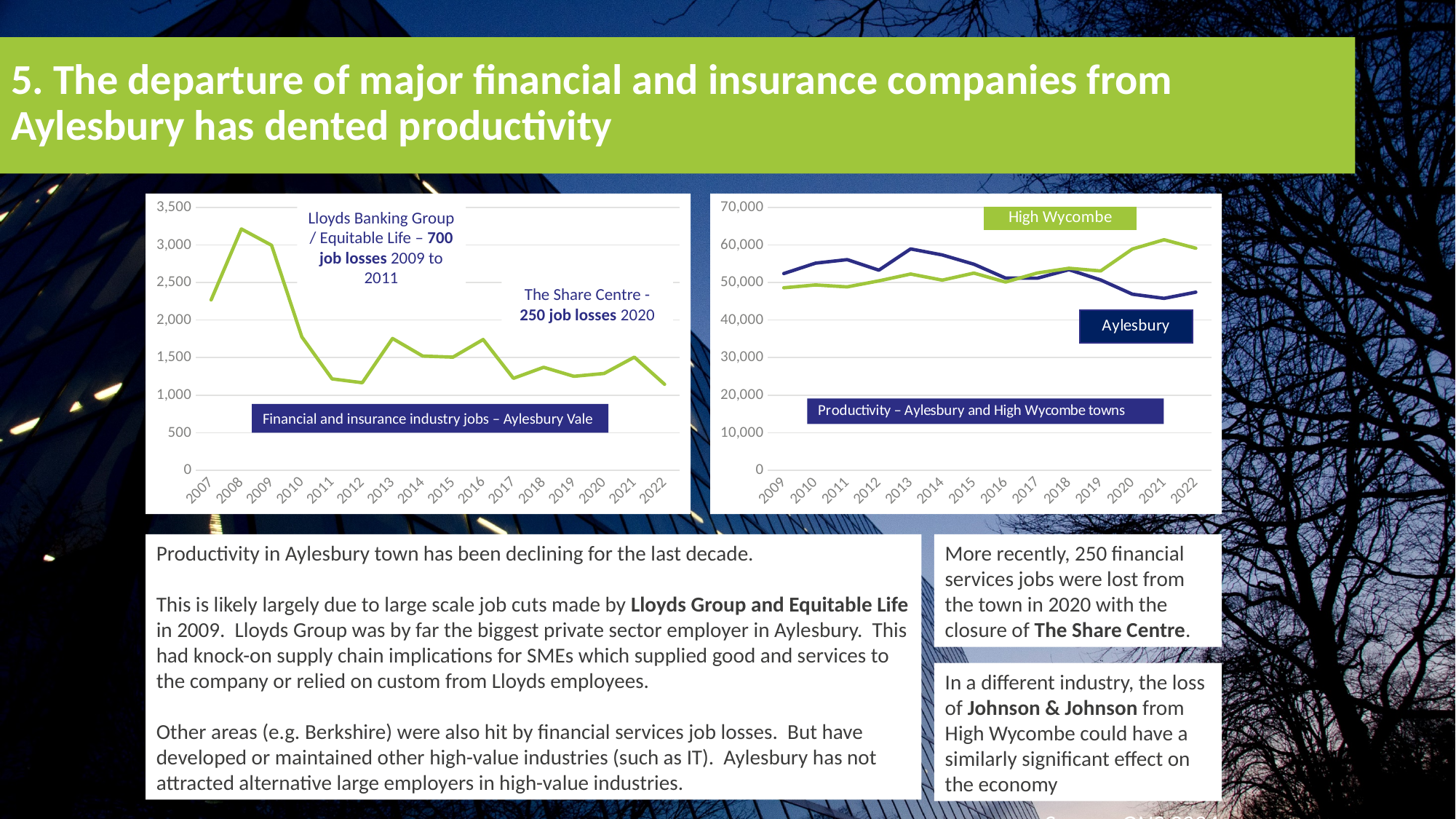
In the 'Productivity – Aylesbury and High Wycombe towns' chart, is the High Wycombe value for 2021 greater or less than 60,000? greater In the 'Financial and insurance industry jobs – Aylesbury Vale' chart, is the value for 2011 greater or less than 1,500? less In the 'Productivity – Aylesbury and High Wycombe towns' chart, is the Aylesbury value for 2022 greater or less than 50,000? less In the 'Productivity – Aylesbury and High Wycombe towns' chart, which town has the higher value in 2022? High Wycombe In the 'Productivity – Aylesbury and High Wycombe towns' chart, does the Aylesbury line overall rise or fall from 2013 to 2022? fall In the 'Financial and insurance industry jobs – Aylesbury Vale' chart, which year has the highest value? 2008 How many years are plotted on the x axis of the 'Financial and insurance industry jobs – Aylesbury Vale' chart? 16 What type of chart is the 'Financial and insurance industry jobs – Aylesbury Vale' chart? line chart How many series are shown in the 'Productivity – Aylesbury and High Wycombe towns' chart? 2 In the 'Financial and insurance industry jobs – Aylesbury Vale' chart, which is larger, the value for 2009 or the value for 2010? 2009